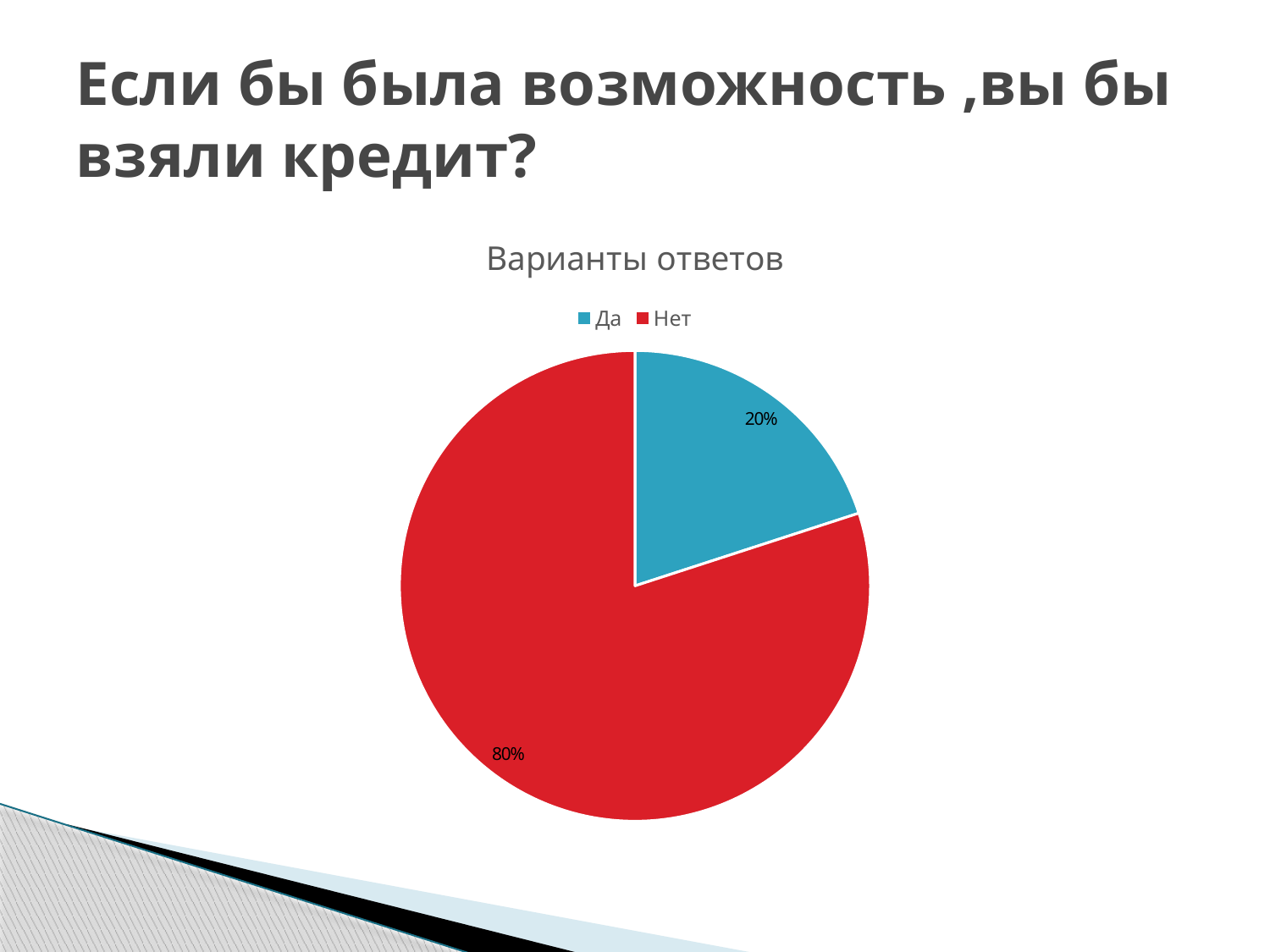
Which is larger, the share for "Да" or the share for "Нет"? Нет How many categories does the pie chart show? 2 What share of the pie does "Да" take? 20% Which category has the largest slice of the pie? Нет How many entries does the legend list? 2 What share of the pie does "Нет" take? 80% What is the difference between the shares for "Нет" and "Да"? 60% What is the title of the chart? Варианты ответов What colour is the slice for "Нет"? red What kind of chart is shown on the slide? pie chart Which category has the smallest slice of the pie? Да